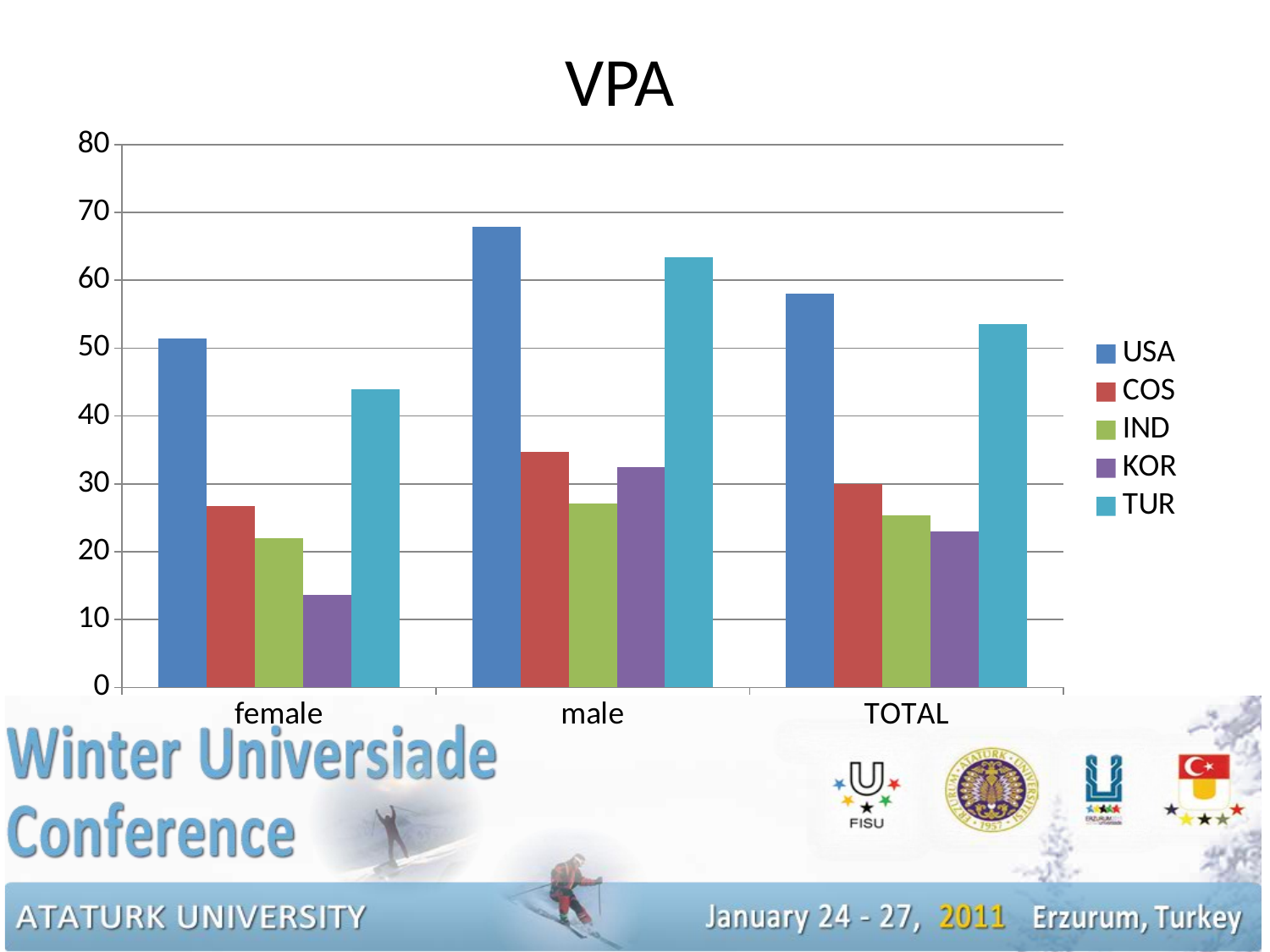
Which series has the lowest value in the female category? KOR Which is larger, the value for TUR in the female category or the value for TUR in the male category? male Is the value for KOR in the female category greater or less than 20? less Which series has the highest value in the male category? USA Is the value for TUR in the TOTAL category greater or less than 50? greater What is the title of the chart? VPA Is the value for USA in the male category greater or less than 60? greater How many categories are shown on the x axis? 3 How many series does the legend list? 5 What type of chart is shown on the slide? bar chart Which is larger, the value for COS in the male category or the value for IND in the male category? COS Which series has the lowest value in the TOTAL category? KOR